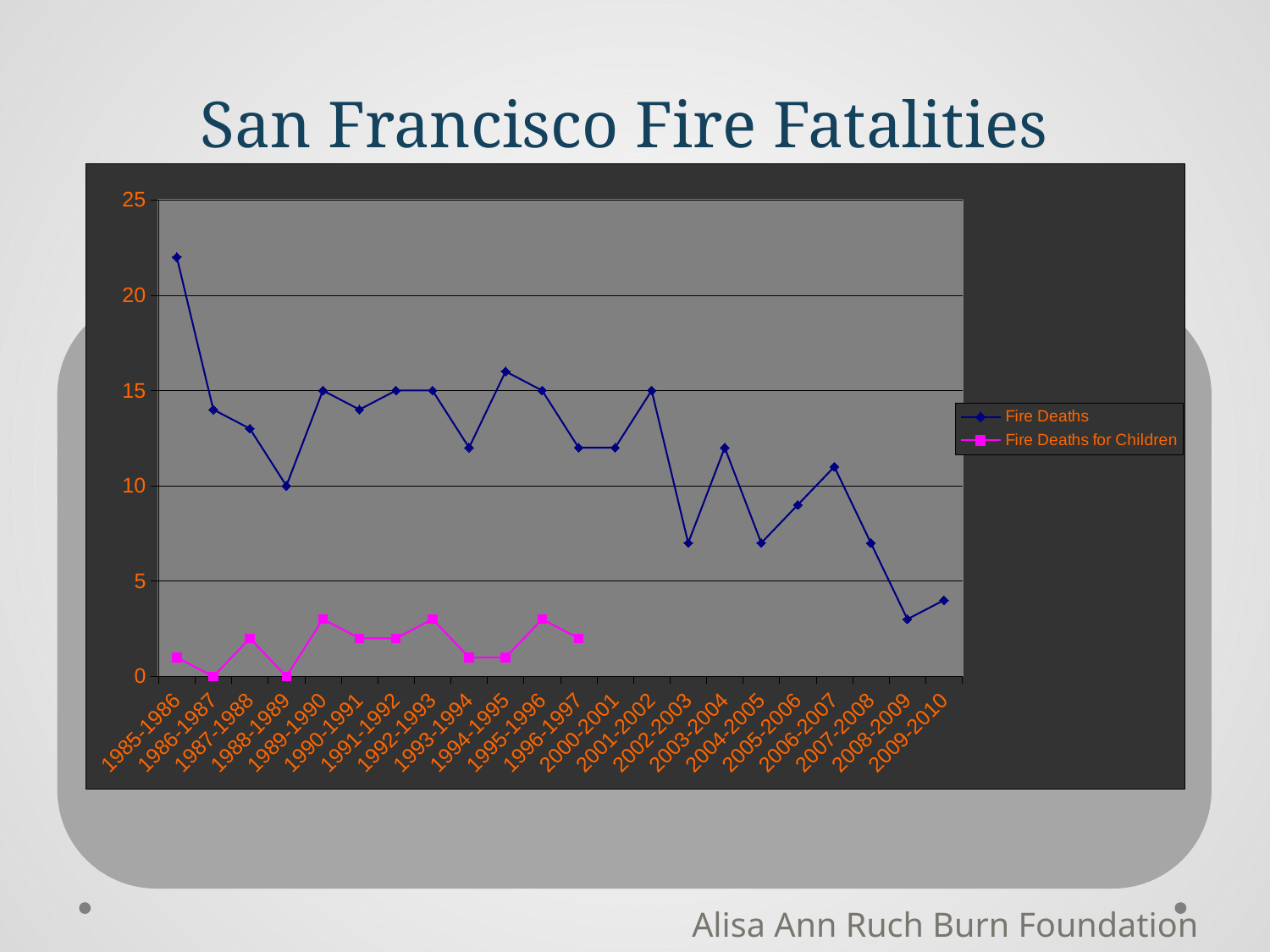
Is the Fire Deaths value for 2008-2009 greater or less than 5? less What is the difference between the Fire Deaths values for 1989-1990 and 1988-1989? 5 What is the Fire Deaths for Children value for 1986-1987? 0 How many series does the legend list? 2 How many year categories are shown on the x axis? 22 Is the Fire Deaths value for 1985-1986 greater or less than 20? greater What is the Fire Deaths value for 1988-1989? 10 Which year has the highest Fire Deaths value? 1985-1986 What is the Fire Deaths value for 1989-1990? 15 Which is larger, the Fire Deaths value for 1985-1986 or for 2009-2010? 1985-1986 What kind of chart is shown on the slide? line chart Overall, do Fire Deaths rise or fall from 1985-1986 to 2009-2010? fall